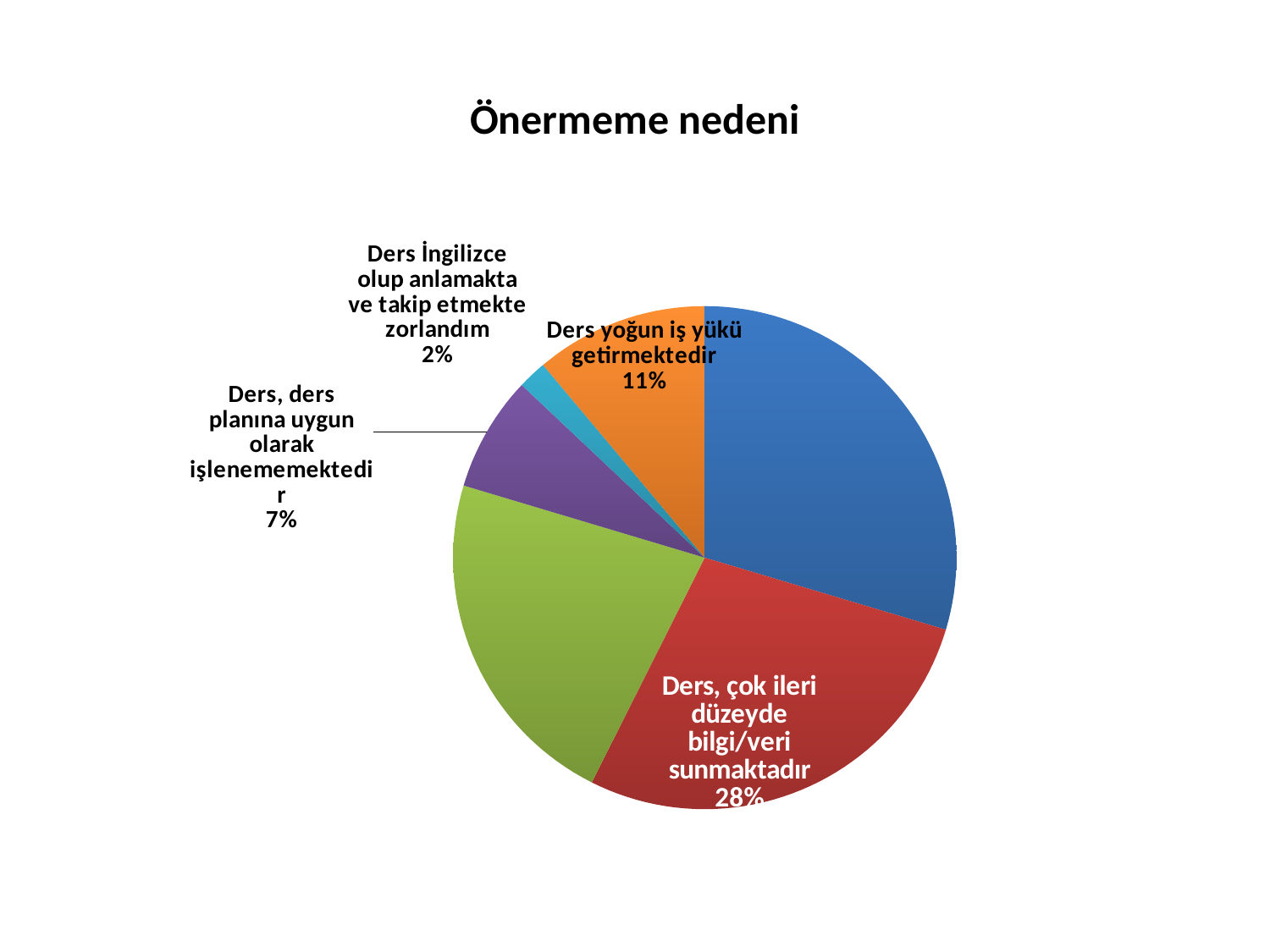
What type of chart is shown on the slide? pie chart What percentage is shown for "Ders yoğun iş yükü getirmektedir"? 11% Which has a smaller share: "Ders İngilizce olup anlamakta ve takip etmekte zorlandım" or "Ders, ders planına uygun olarak işlenememektedir"? Ders İngilizce olup anlamakta ve takip etmekte zorlandım What percentage is shown for "Ders İngilizce olup anlamakta ve takip etmekte zorlandım"? 2% What percentage is shown for "Ders, ders planına uygun olarak işlenememektedir"? 7% What percentage is shown for "Ders, çok ileri düzeyde bilgi/veri sunmaktadır"? 28% What is the difference in percentage points between "Ders, ders planına uygun olarak işlenememektedir" and "Ders İngilizce olup anlamakta ve takip etmekte zorlandım"? 5% What is the title of the chart? Önermeme nedeni What colour is the slice for "Ders, çok ileri düzeyde bilgi/veri sunmaktadır"? red Which has a larger share: "Ders yoğun iş yükü getirmektedir" or "Ders, ders planına uygun olarak işlenememektedir"? Ders yoğun iş yükü getirmektedir How many slices does the pie chart have? 6 What is the difference in percentage points between "Ders, çok ileri düzeyde bilgi/veri sunmaktadır" and "Ders yoğun iş yükü getirmektedir"? 17%